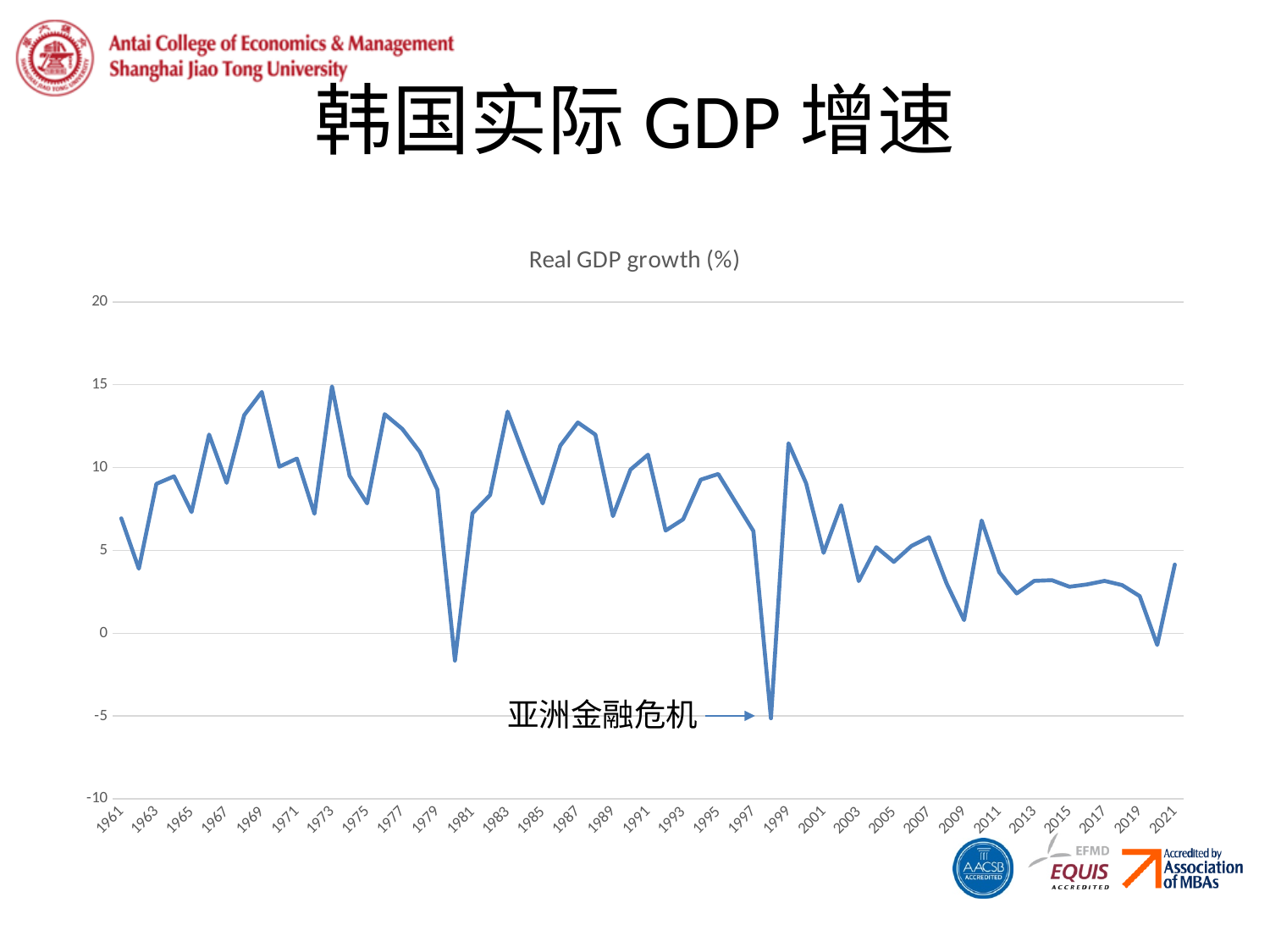
Which year has the lowest real GDP growth on the chart? 1998 What event is annotated with an arrow pointing to the sharp dip in the late 1990s? 亚洲金融危机 Is the value for 1999 greater or less than 10? greater Is the value for 2009 greater or less than 5? less Is the value for 1998 greater or less than 0? less What is the title printed above the chart's plot area? Real GDP growth (%) Which is larger, the value for 1973 or the value for 2021? 1973 What kind of chart is shown on the slide? line chart Overall, do the values rise or fall from 1961 to 2021? fall